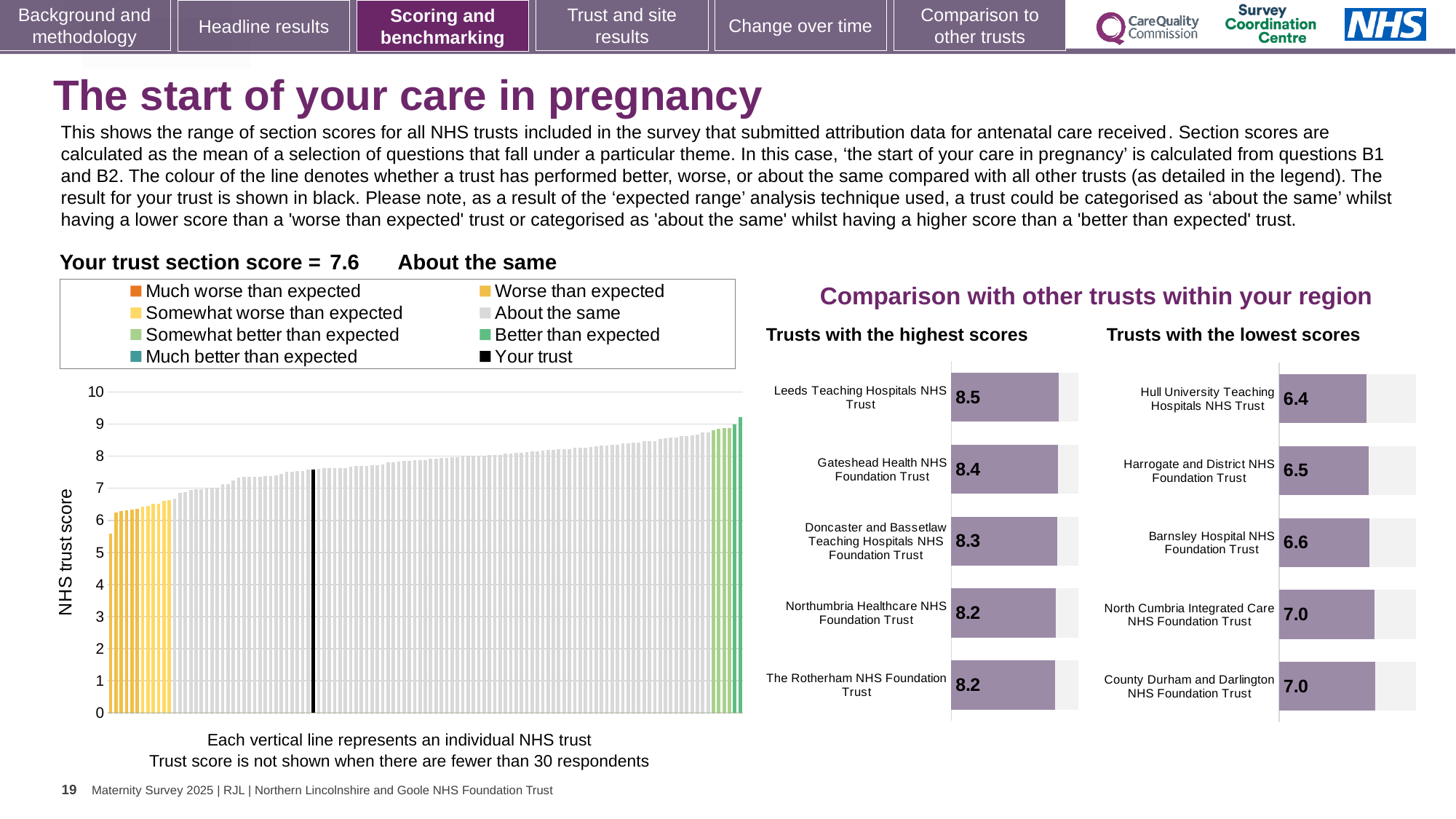
In the 'Trusts with the lowest scores' chart, which trust has the lowest score? Hull University Teaching Hospitals NHS Trust In the 'Trusts with the highest scores' chart, which trust has the highest score? Leeds Teaching Hospitals NHS Trust In the 'Trusts with the lowest scores' chart, which has the larger score: Barnsley Hospital NHS Foundation Trust or Harrogate and District NHS Foundation Trust? Barnsley Hospital NHS Foundation Trust In the 'Trusts with the highest scores' chart, what is the score for Leeds Teaching Hospitals NHS Trust? 8.5 In the 'Trusts with the lowest scores' chart, what is the score for Hull University Teaching Hospitals NHS Trust? 6.4 In the 'Trusts with the highest scores' chart, what is the difference between the scores of Leeds Teaching Hospitals NHS Trust and Northumbria Healthcare NHS Foundation Trust? 0.3 What kind of chart is the large chart on the left showing all NHS trusts? Bar chart In the large chart on the left showing all NHS trusts, is the value of the leftmost (lowest) bar greater or less than 6? less In the large chart on the left showing all NHS trusts, what is the section score for your trust (the black bar)? 7.6 In the 'Trusts with the highest scores' chart, what is the score for Doncaster and Bassetlaw Teaching Hospitals NHS Foundation Trust? 8.3 In the 'Trusts with the lowest scores' chart, what is the score for North Cumbria Integrated Care NHS Foundation Trust? 7.0 How many trusts are shown in the 'Trusts with the lowest scores' chart? 5